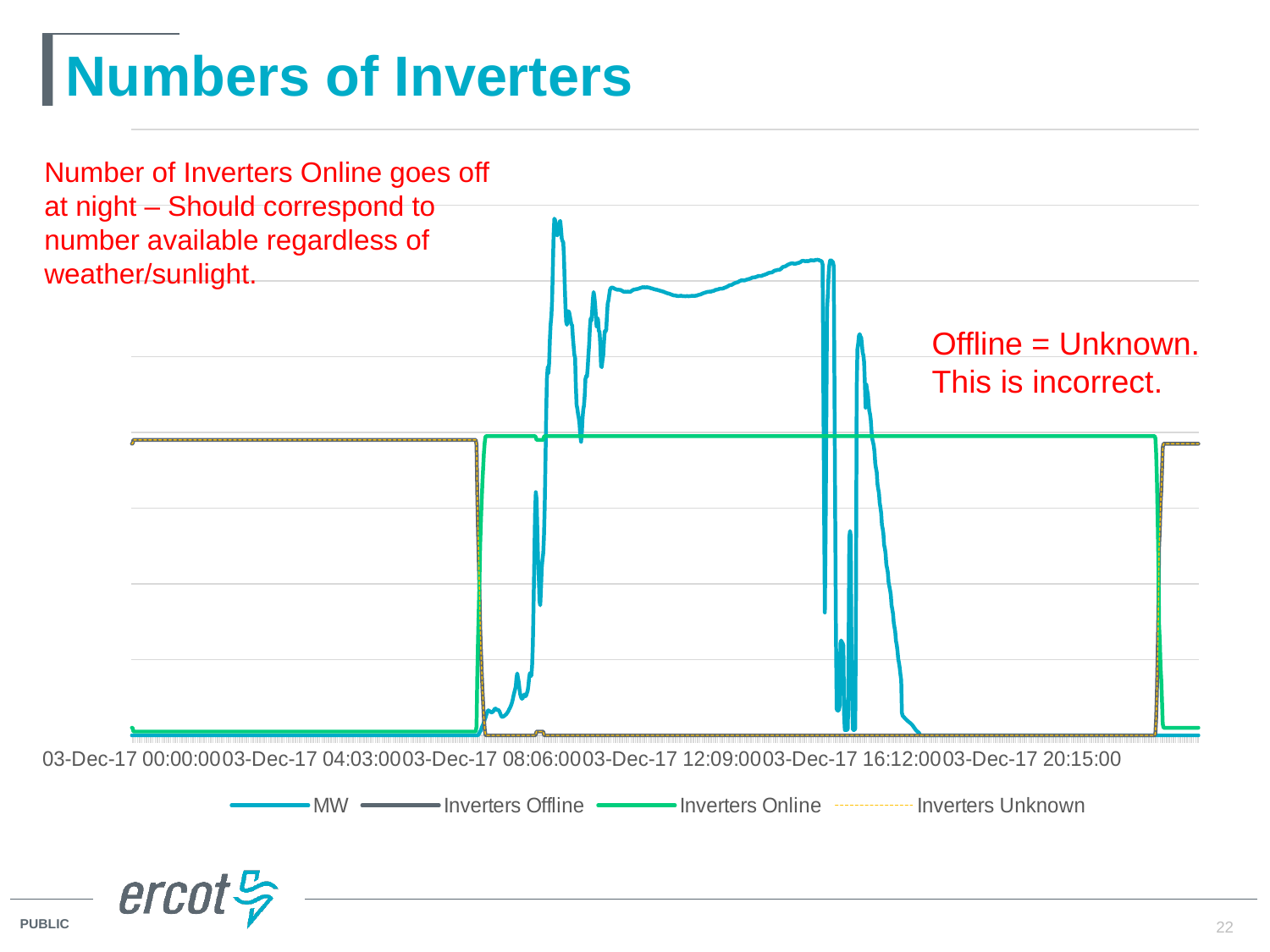
Between 03-Dec-17 16:12:00 and 03-Dec-17 20:15:00, does the MW series rise or fall? fall What kind of chart is shown on the slide? line chart Is the Inverters Online series higher during the daytime hours or during the night-time hours? daytime How many time labels are shown along the x axis? 6 What is the title of the slide containing the chart? Numbers of Inverters What are the series names listed in the legend? MW, Inverters Offline, Inverters Online, Inverters Unknown Between 03-Dec-17 04:03:00 and 03-Dec-17 12:09:00, does the MW series overall rise or fall? rise Which series reaches the highest point on the chart? MW Is the Inverters Online series higher at 03-Dec-17 12:09:00 or at 03-Dec-17 00:00:00? 03-Dec-17 12:09:00 How many series does the legend list? 4